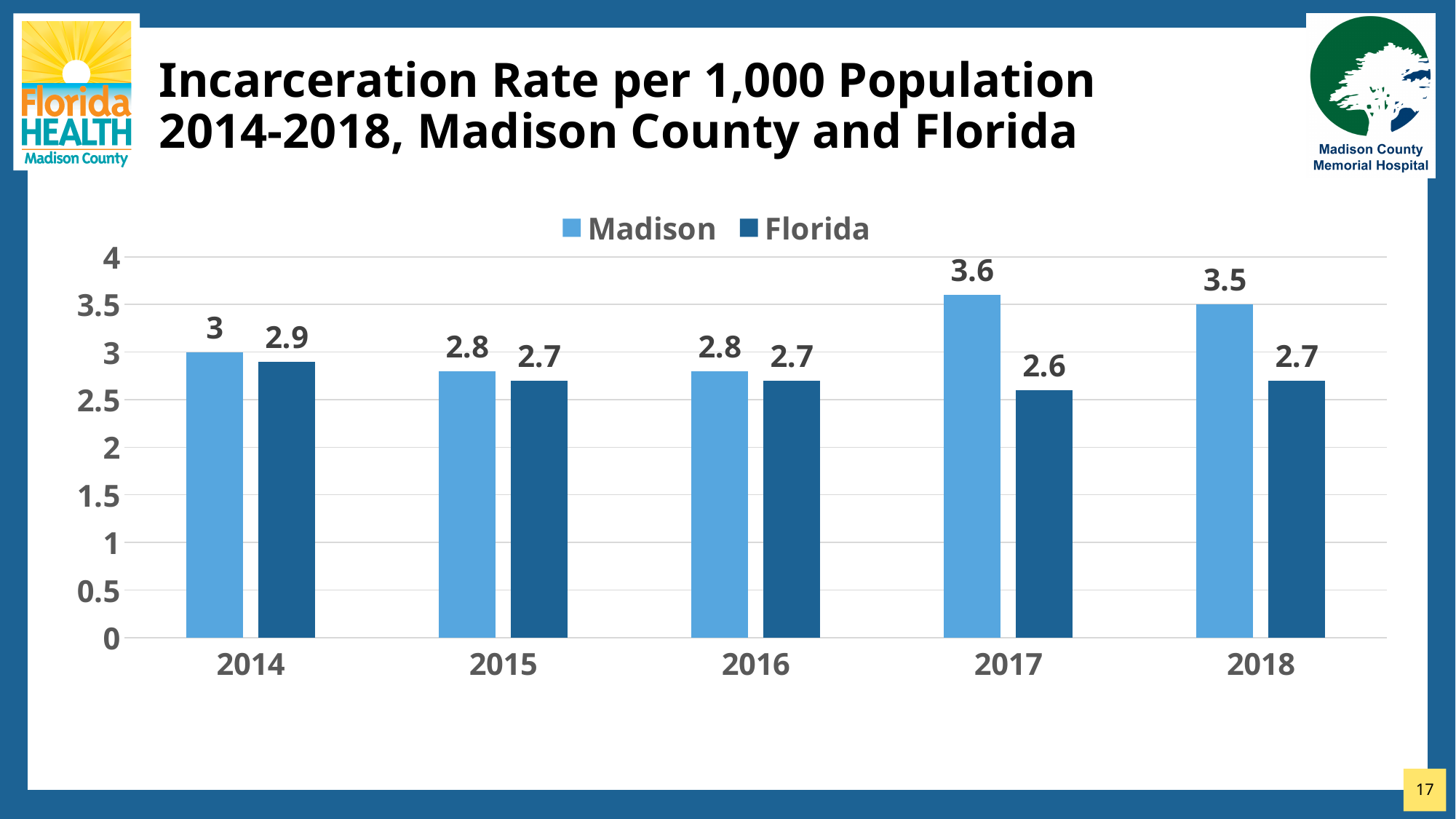
What is the difference between the Madison rate in 2018 and the Madison rate in 2014? 0.5 Which series is shown in the darker blue colour? Florida How many series does the legend list? 2 In which year is the Florida incarceration rate lowest? 2017 What is the incarceration rate for Madison in 2017? 3.6 What is the incarceration rate for Florida in 2014? 2.9 How many years are shown on the x axis? 5 What kind of chart is shown on the slide? Bar chart What is the difference between the Madison and Florida rates in 2017? 1 In which year is the Madison incarceration rate highest? 2017 Which is larger in 2016, the Madison rate or the Florida rate? Madison What is the incarceration rate for Madison in 2015? 2.8